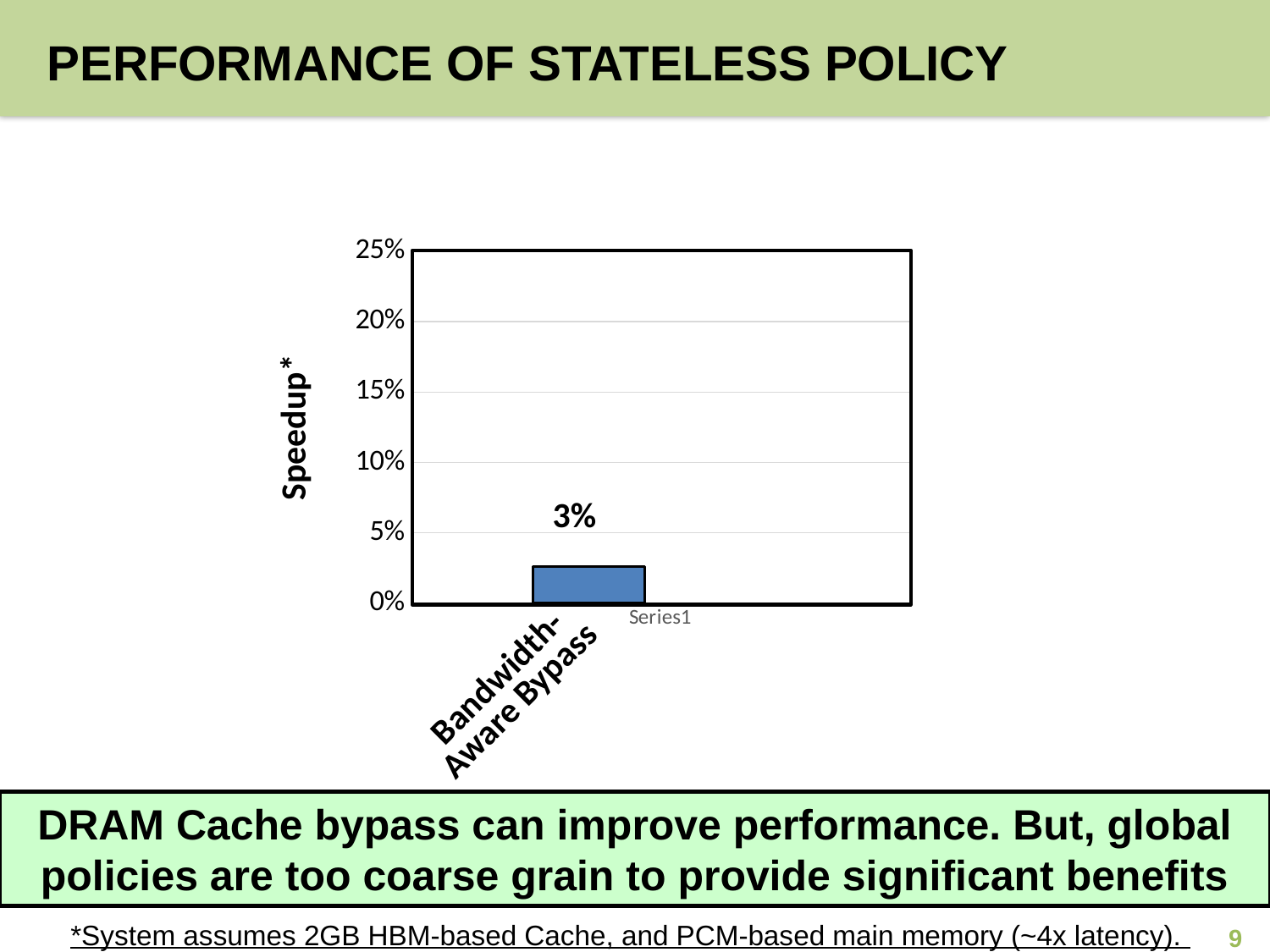
Is the value for Bandwidth-Aware Bypass greater or less than 5%? less What kind of chart is shown on the slide? bar chart What is the label on the vertical axis of the chart? Speedup* Is the value for Bandwidth-Aware Bypass greater or less than 10%? less How many bars are plotted in the chart? 1 What is the name of the category plotted in the chart? Bandwidth-Aware Bypass What is the speedup shown for Bandwidth-Aware Bypass? 3% How many series does the legend list? 1 What is the highest value shown on the vertical axis? 25%